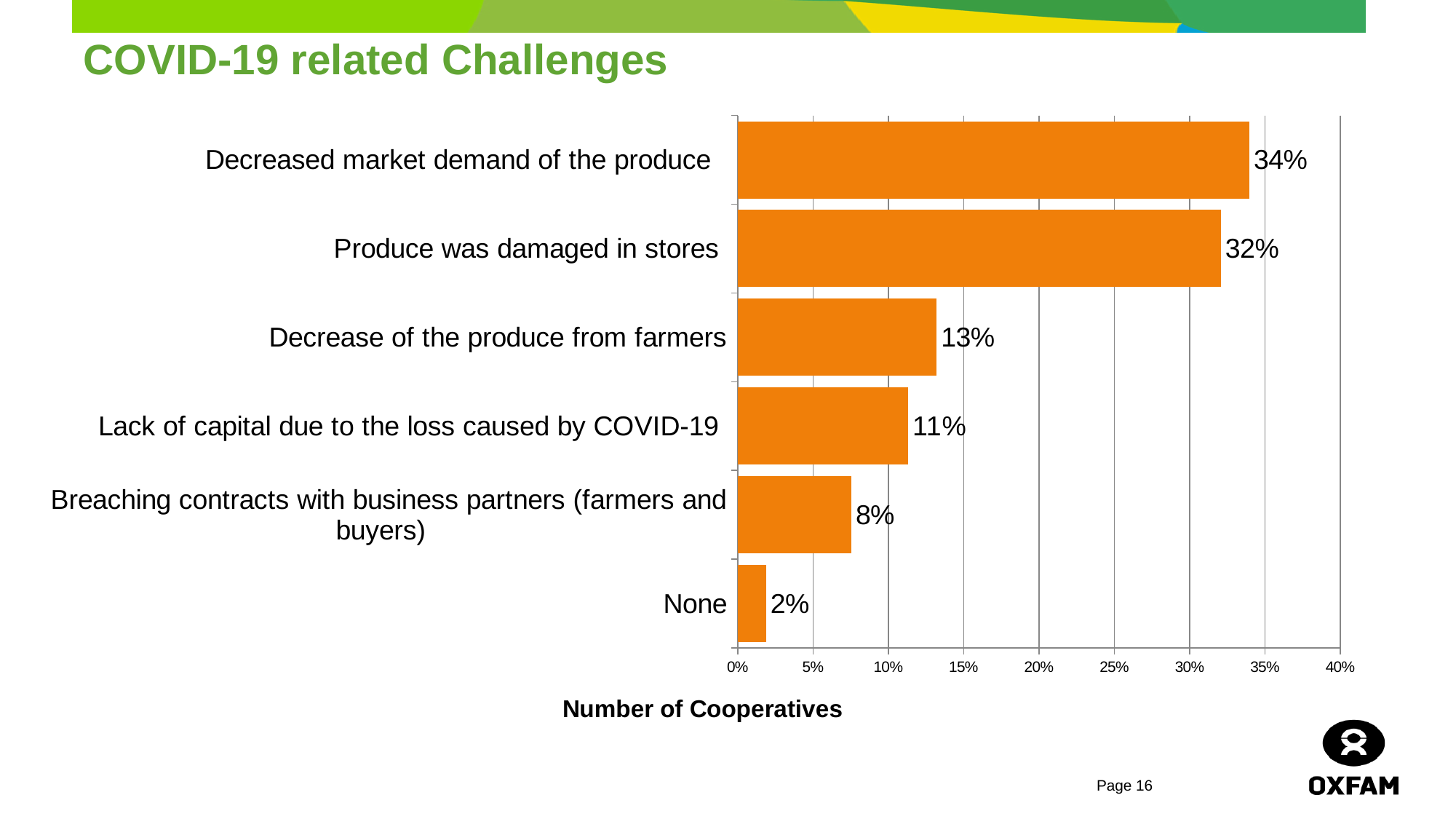
Which is larger: 'Decrease of the produce from farmers' or 'Breaching contracts with business partners (farmers and buyers)'? Decrease of the produce from farmers What percentage of cooperatives reported decreased market demand of the produce? 34% What kind of chart is shown on the slide? Bar chart What is the title of the slide? COVID-19 related Challenges What is the value for 'None'? 2% What is the label of the horizontal axis? Number of Cooperatives Which challenge has the highest percentage? Decreased market demand of the produce What is the difference between 'Decreased market demand of the produce' and 'Produce was damaged in stores'? 2% What is the value for 'Produce was damaged in stores'? 32% What percentage is shown for 'Lack of capital due to the loss caused by COVID-19'? 11% How many categories are shown in the chart? 6 Which category has the lowest value? None